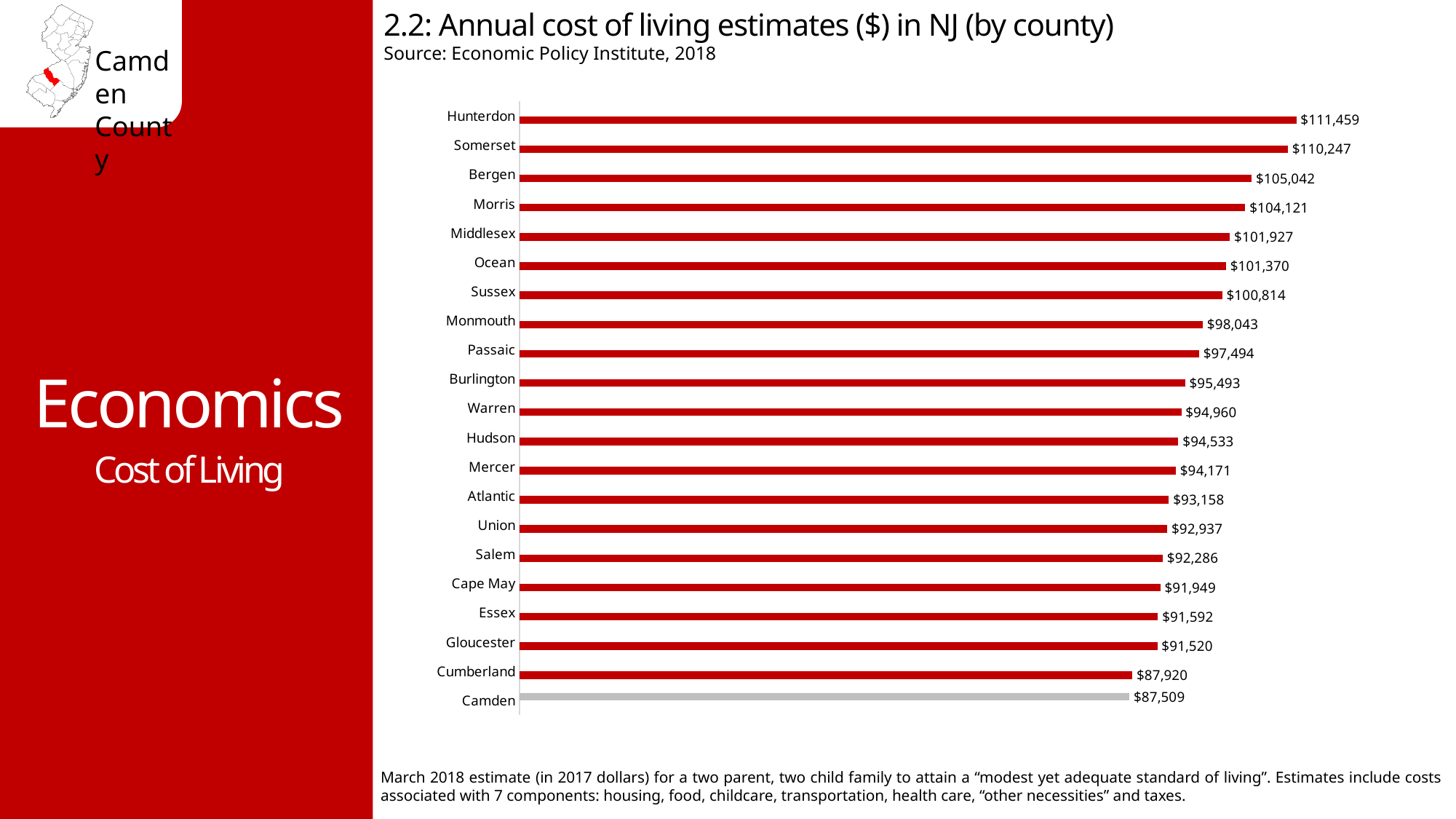
Which county has a higher cost of living estimate, Morris or Ocean? Morris Which county has the highest annual cost of living estimate? Hunterdon What is the difference between the cost of living estimates for Hunterdon and Camden? $23,950 What type of chart is used on this slide? Bar chart What is the source cited for the chart? Economic Policy Institute, 2018 What is the annual cost of living estimate for Camden County? $87,509 What is the annual cost of living estimate for Gloucester County? $91,520 Which county's bar is shown in a different colour (grey) from the others? Camden Which county has the lowest annual cost of living estimate? Camden What is the difference between the cost of living estimates for Cumberland and Camden? $411 How many counties are shown in the chart? 21 What is the annual cost of living estimate for Bergen County? $105,042